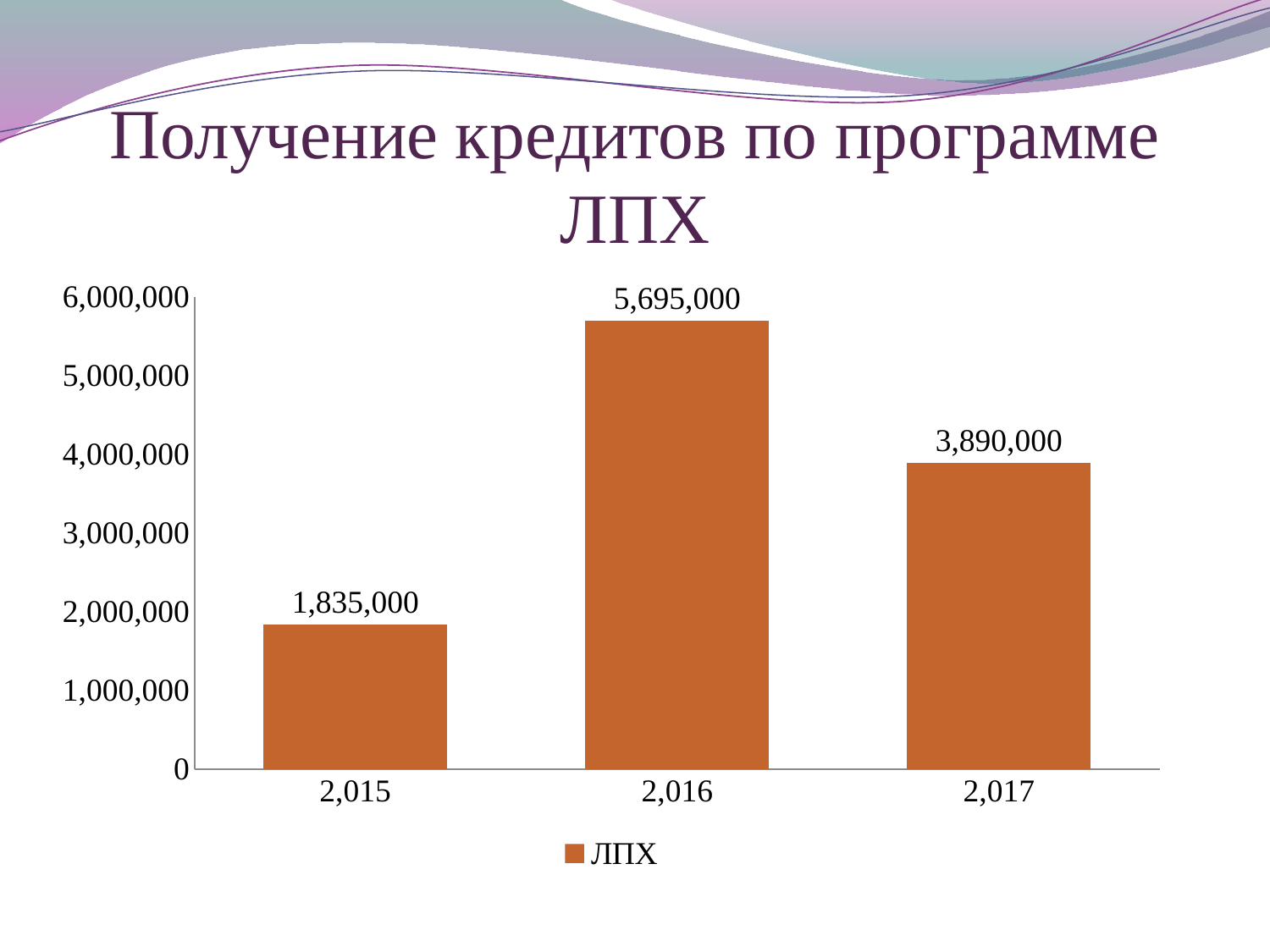
What is the value for 2,017? 3,890,000 What kind of chart is shown on the slide? bar chart Which is larger, the value for 2,015 or the value for 2,017? 2,017 How many series does the legend list? 1 What is the difference between the values for 2,016 and 2,017? 1,805,000 Which category has the lowest value? 2,015 Is the value for 2,016 greater or less than 5,000,000? greater Which category has the highest value? 2,016 What is the difference between the values for 2,017 and 2,015? 2,055,000 How many categories are shown on the x axis? 3 What is the value for 2,016? 5,695,000 What is the value for 2,015? 1,835,000